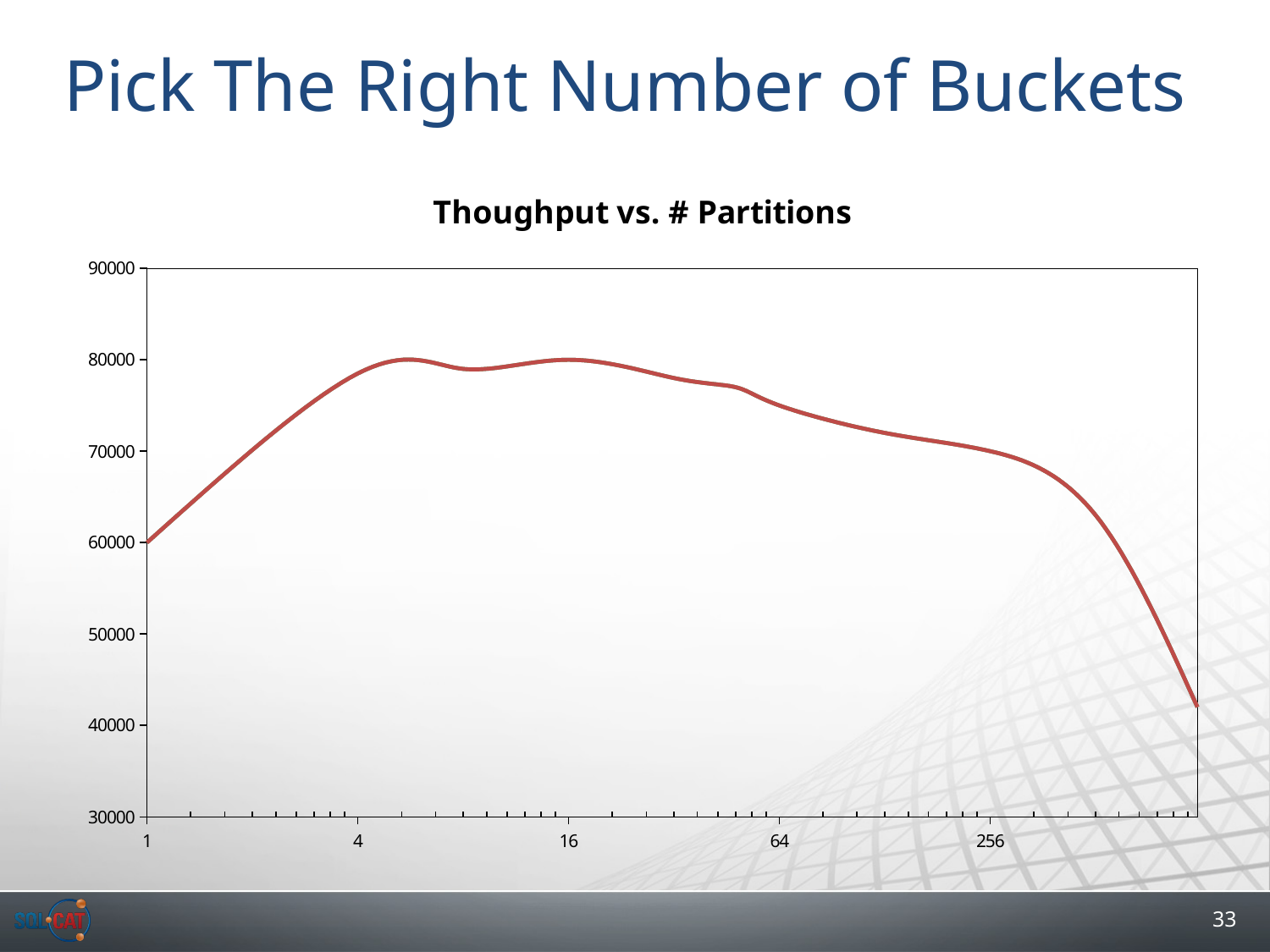
What is the highest value shown on the y axis? 90000 Does the throughput rise or fall as the number of partitions increases from 64 to 256? fall Is the throughput at 64 partitions greater or less than 80000? less Is the throughput at 16 partitions greater or less than 70000? greater What kind of chart is shown on the slide? line chart Is the throughput at 256 partitions greater or less than 80000? less Which is larger, the throughput at 16 partitions or at 256 partitions? 16 partitions What is the title of the chart? Thoughput vs. # Partitions Which is larger, the throughput at 1 partition or at 4 partitions? 4 partitions